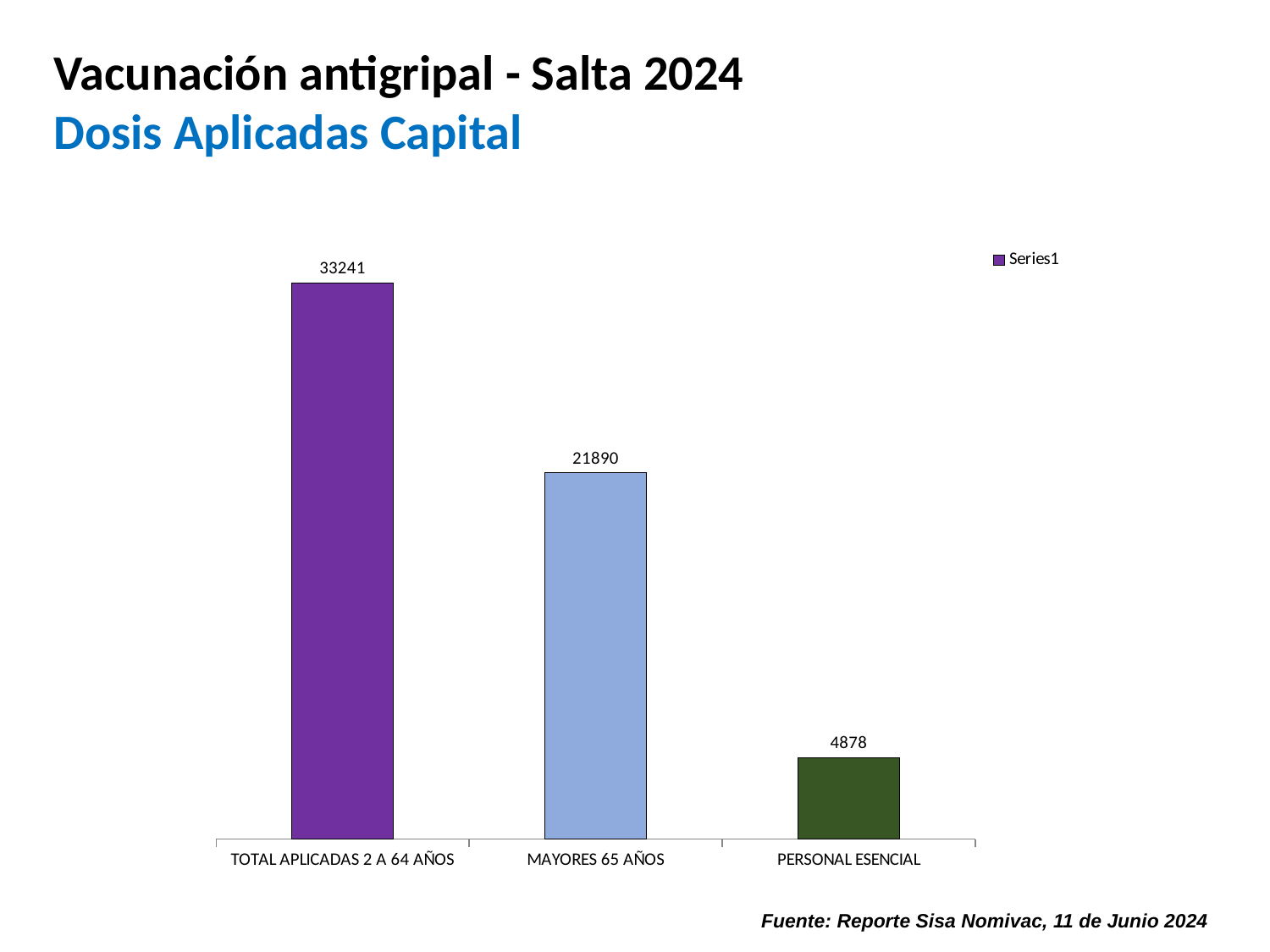
What is the value for MAYORES 65 AÑOS? 21890 How many categories are shown on the chart? 3 How many series does the legend list? 1 What is the value for TOTAL APLICADAS 2 A 64 AÑOS? 33241 Which category has the highest value? TOTAL APLICADAS 2 A 64 AÑOS What is the difference between the values for TOTAL APLICADAS 2 A 64 AÑOS and MAYORES 65 AÑOS? 11351 Which is larger, the value for MAYORES 65 AÑOS or the value for PERSONAL ESENCIAL? MAYORES 65 AÑOS What kind of chart is shown on the slide? Bar chart What is the name of the series listed in the legend? Series1 What is the difference between the values for MAYORES 65 AÑOS and PERSONAL ESENCIAL? 17012 Which category has the lowest value? PERSONAL ESENCIAL What is the value for PERSONAL ESENCIAL? 4878